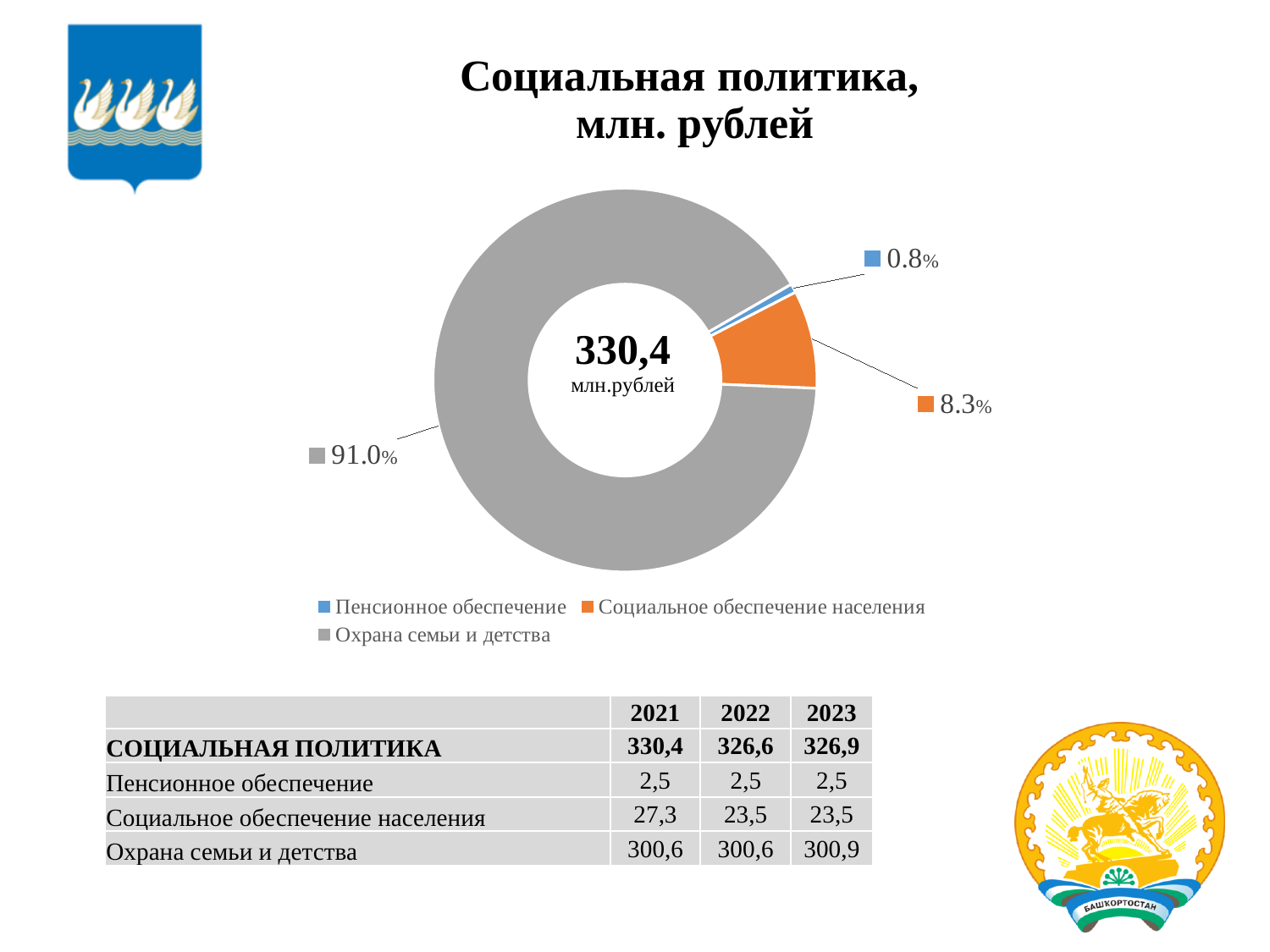
What share of the pie does Социальное обеспечение населения represent? 8.3% What share of the pie does Охрана семьи и детства represent? 91.0% What total value is printed in the centre of the chart? 330,4 млн.рублей Which category has the smallest slice of the chart? Пенсионное обеспечение What kind of chart is shown on the slide? Pie (doughnut) chart What colour is the Социальное обеспечение населения slice? Orange What share of the pie does Пенсионное обеспечение represent? 0.8% How many slices does the chart have? 3 Which slice is larger: Социальное обеспечение населения or Пенсионное обеспечение? Социальное обеспечение населения How many entries does the chart legend list? 3 What is the difference in percentage points between the Охрана семьи и детства slice and the Социальное обеспечение населения slice? 82.7 Which category has the largest slice of the chart? Охрана семьи и детства